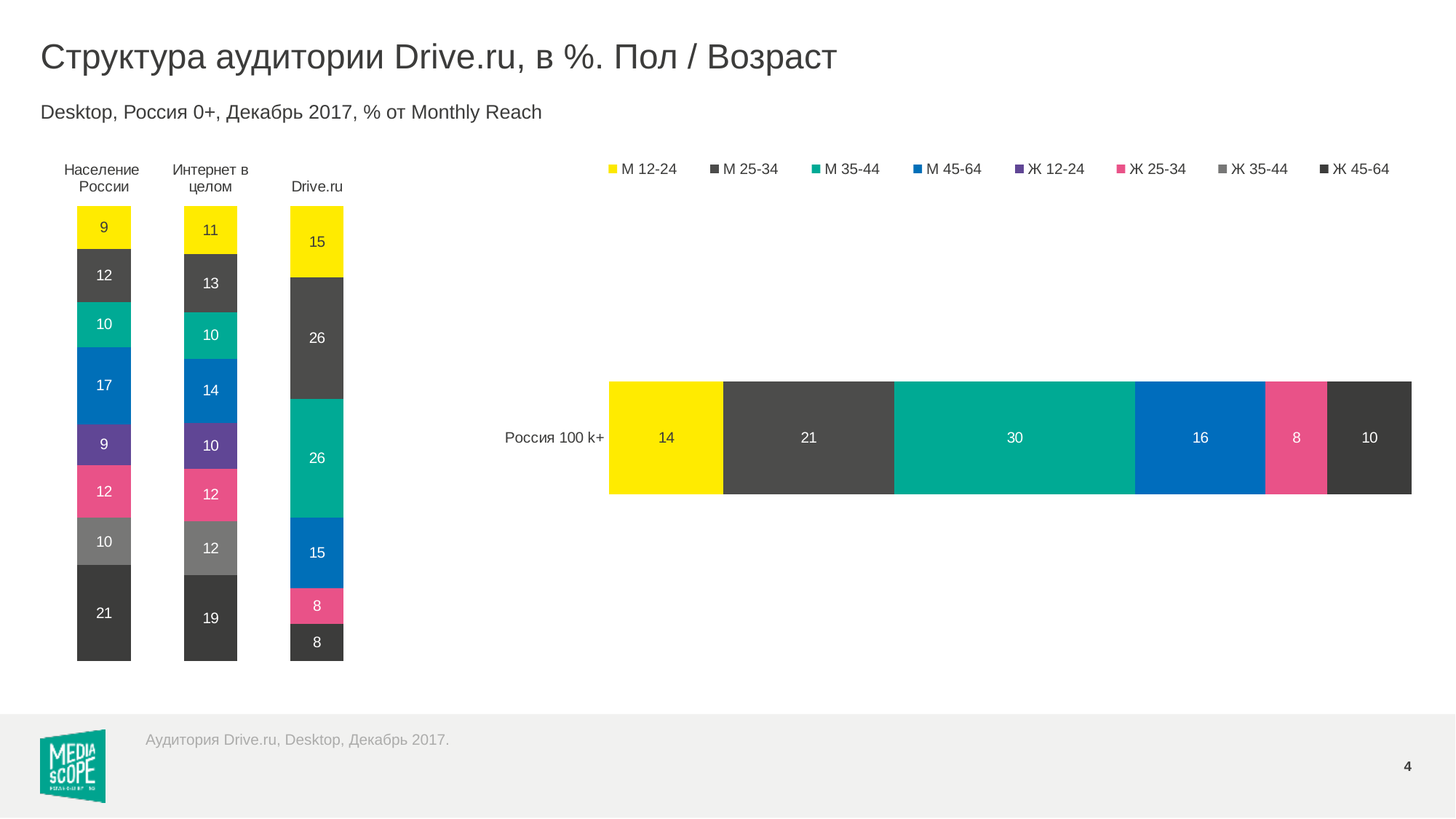
In the left chart, what is the value of the bottom (Ж 45-64) segment of the Население России bar? 21 In the right chart (Россия 100 k+), what is the value of the М 35-44 segment? 30 In the right chart, what is the total of all segments in the Россия 100 k+ bar? 99 How many series does the legend on the slide list? 8 In the right chart (Россия 100 k+), which series has the largest segment? М 35-44 In the right chart (Россия 100 k+), which series has the smallest segment? Ж 25-34 How many stacked bars are shown in the left chart? 3 In the left chart, which bar has the larger М 45-64 segment: Население России or Интернет в целом? Население России In the left chart, what is the difference between the М 12-24 segment of the Drive.ru bar and the М 12-24 segment of the Население России bar? 6 What kind of chart is the right chart (Россия 100 k+)? Stacked bar chart How many segments does the Drive.ru bar in the left chart contain? 6 In the left chart, what is the value of the М 25-34 segment in the Drive.ru bar? 26